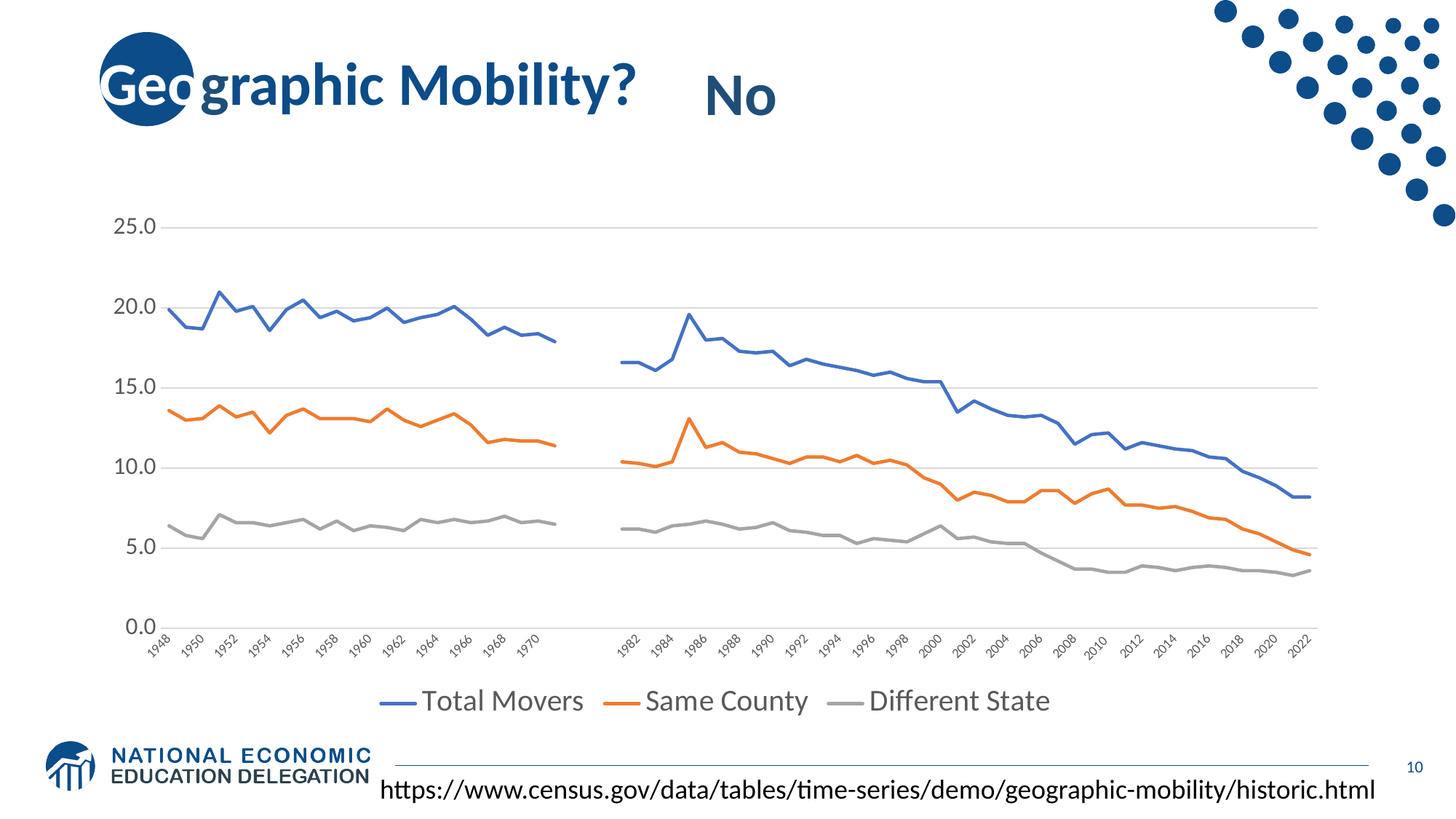
Is the value for Total Movers in 2022 greater or less than 10? less Is the value for Total Movers in 1985 greater or less than 15? greater In 2022, which is larger: Total Movers or Different State? Total Movers Do the Total Movers values rise or fall from 1982 to 2022? fall Which series is plotted with the orange line? Same County Which series has the highest values throughout the chart? Total Movers What is the first year shown on the x axis? 1948 Is the value for Same County in 1948 greater or less than 10? greater Which series has the lowest values throughout the chart? Different State How many series does the chart's legend list? 3 What kind of chart is shown on the slide? line chart